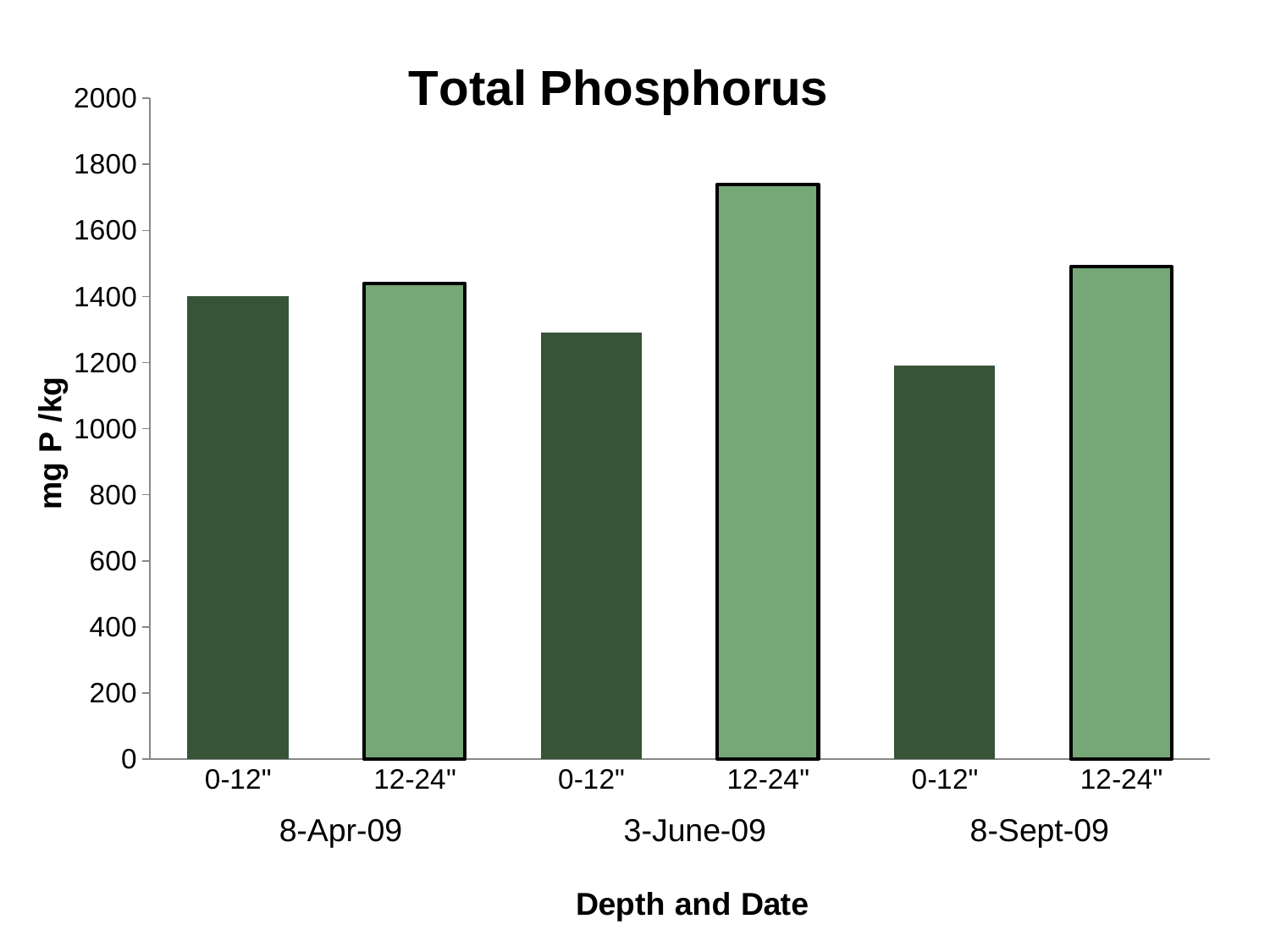
Across the three dates, do the 0-12" values rise or fall from 8-Apr-09 to 8-Sept-09? fall What is the title of the chart? Total Phosphorus Is the value for 0-12" on 3-June-09 greater or less than 1200? greater On 8-Sept-09, which depth has the larger total phosphorus value, 0-12" or 12-24"? 12-24" Is the value for 0-12" on 8-Sept-09 greater or less than 1400? less Which bar has the highest total phosphorus value? 12-24" on 3-June-09 What kind of chart is shown on the slide? bar chart Which bar has the lowest total phosphorus value? 0-12" on 8-Sept-09 What is the label on the vertical axis of the chart? mg P /kg Is the value for 12-24" on 3-June-09 greater or less than 1600? greater How many bars are plotted in the chart? 6